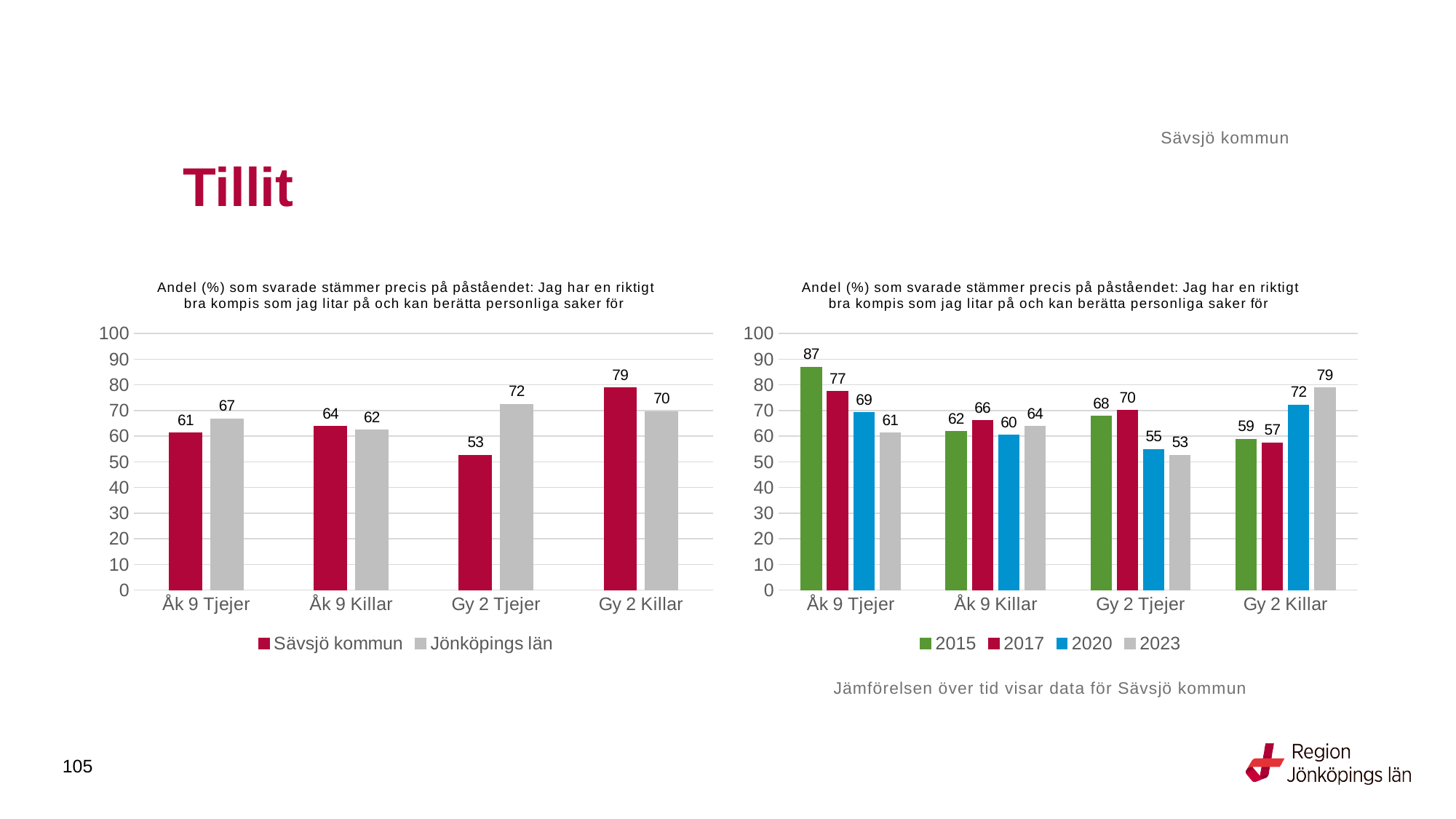
In the left chart, which category has the highest value for Sävsjö kommun? Gy 2 Killar In the left chart, what is the value for Sävsjö kommun for Gy 2 Tjejer? 53 In the right chart, what is the value for 2020 for Gy 2 Killar? 72 In the left chart, what is the value for Jönköpings län for Åk 9 Tjejer? 67 How many categories are shown on the x axis of the left chart? 4 In the left chart, which is larger for Åk 9 Killar: Sävsjö kommun or Jönköpings län? Sävsjö kommun What kind of chart is the left chart? Bar chart In the right chart, what is the difference between the 2015 and 2023 values for Åk 9 Tjejer? 26 In the right chart, what is the value for 2015 for Åk 9 Tjejer? 87 In the right chart, which year has the lowest value for Gy 2 Tjejer? 2023 In the left chart, what is the difference between Jönköpings län and Sävsjö kommun for Gy 2 Tjejer? 19 How many series does the legend of the right chart list? 4